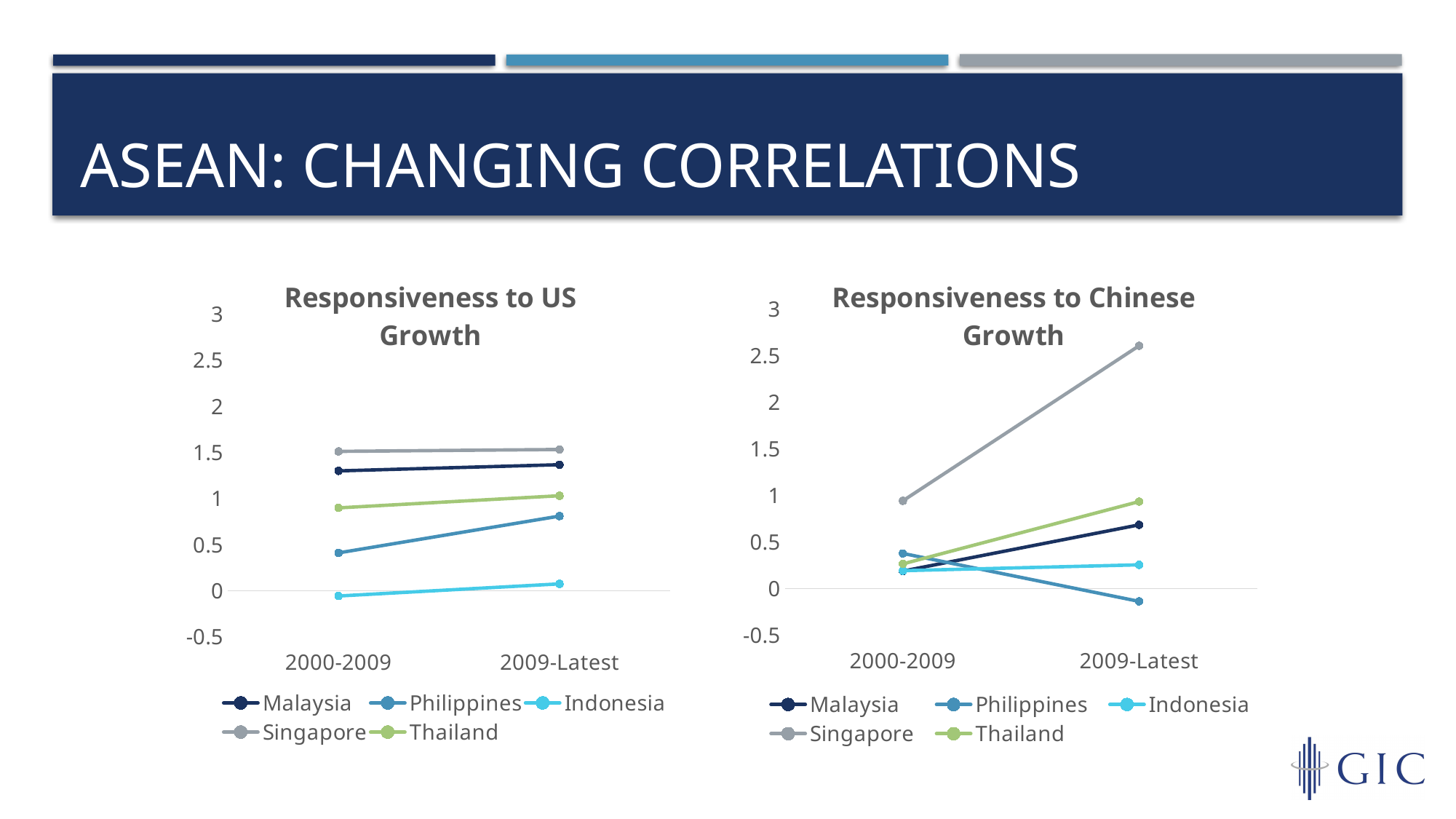
In the "Responsiveness to Chinese Growth" chart, which country has the highest value for 2009-Latest? Singapore What kind of chart is the "Responsiveness to US Growth" chart? line chart In the "Responsiveness to Chinese Growth" chart, is the value for Singapore in 2009-Latest greater or less than 2? greater In the "Responsiveness to US Growth" chart, which country has the lowest value for 2000-2009? Indonesia In the "Responsiveness to US Growth" chart, is the value for the Philippines in 2000-2009 greater or less than 0.5? less How many periods are shown on the x axis of the "Responsiveness to US Growth" chart? 2 How many series does the legend of the "Responsiveness to Chinese Growth" chart list? 5 In the "Responsiveness to Chinese Growth" chart, which is larger for 2009-Latest: Thailand or Indonesia? Thailand In the "Responsiveness to Chinese Growth" chart, does the Philippines line rise or fall from 2000-2009 to 2009-Latest? fall In the "Responsiveness to US Growth" chart, which country has the highest value for 2009-Latest? Singapore In the "Responsiveness to Chinese Growth" chart, does the Singapore line rise or fall from 2000-2009 to 2009-Latest? rise In the "Responsiveness to Chinese Growth" chart, which country has the lowest value for 2009-Latest? Philippines